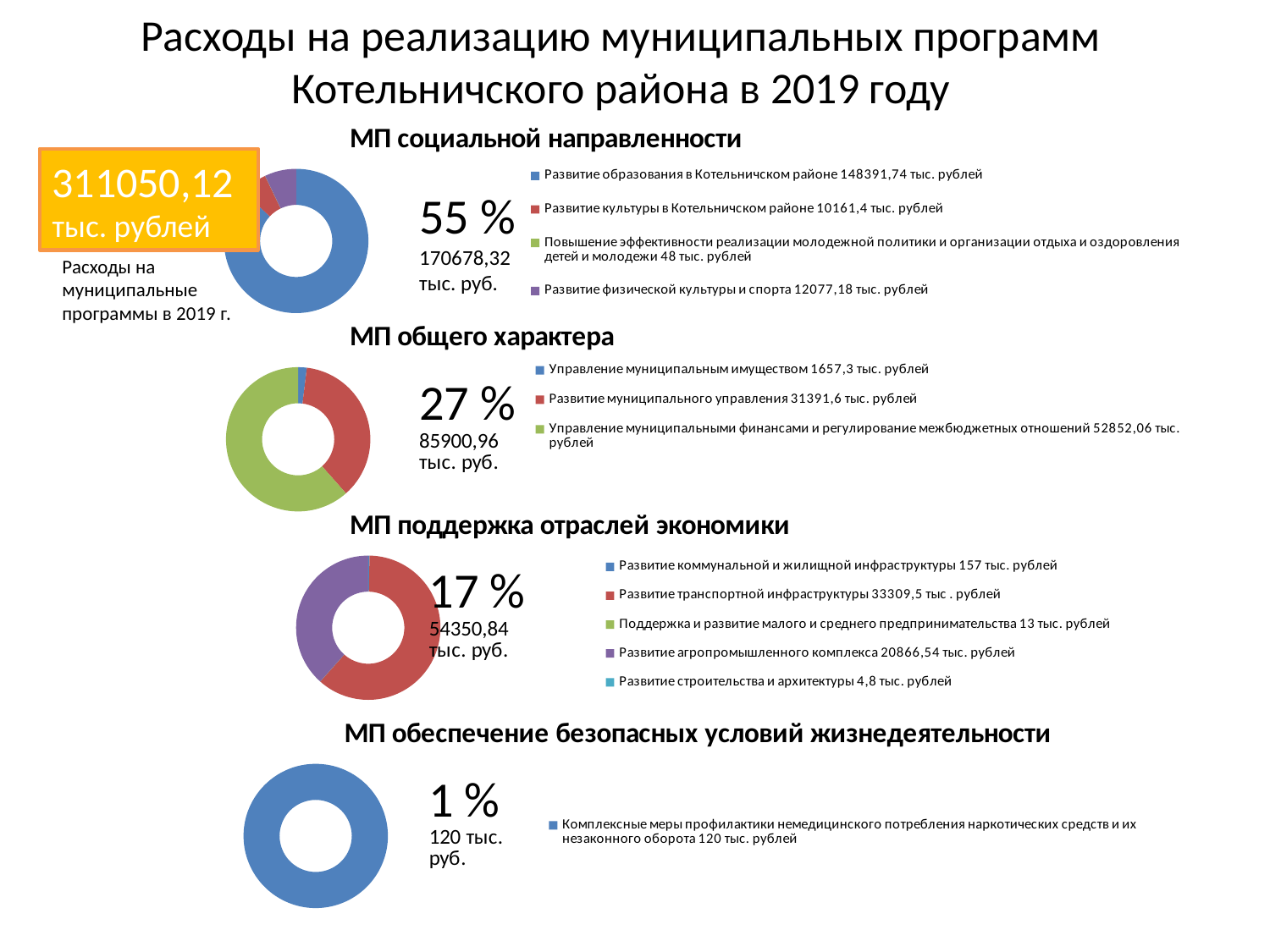
What kind of chart is used for 'МП поддержка отраслей экономики'? Doughnut chart How many legend entries does the chart 'МП поддержка отраслей экономики' list? 5 In the chart 'МП поддержка отраслей экономики', what is the value for 'Развитие агропромышленного комплекса'? 20866,54 тыс. рублей In the chart 'МП общего характера', which is larger: 'Управление муниципальным имуществом' or 'Развитие муниципального управления'? Развитие муниципального управления In the chart 'МП общего характера', which legend entry has the largest value? Управление муниципальными финансами и регулирование межбюджетных отношений In the chart 'МП общего характера', what is the value for 'Развитие муниципального управления'? 31391,6 тыс. рублей In the chart 'МП социальной направленности', which legend entry has the smallest value? Повышение эффективности реализации молодежной политики и организации отдыха и оздоровления детей и молодежи In the chart 'МП социальной направленности', what is the value for 'Развитие образования в Котельничском районе'? 148391,74 тыс. рублей What total value is shown next to the chart 'МП обеспечение безопасных условий жизнедеятельности'? 120 тыс. руб. In the chart 'МП поддержка отраслей экономики', what is the difference between 'Развитие транспортной инфраструктуры' and 'Развитие агропромышленного комплекса'? 12442,96 тыс. рублей What percentage is shown next to the chart 'МП социальной направленности'? 55 % How many legend entries does the chart 'МП социальной направленности' list? 4